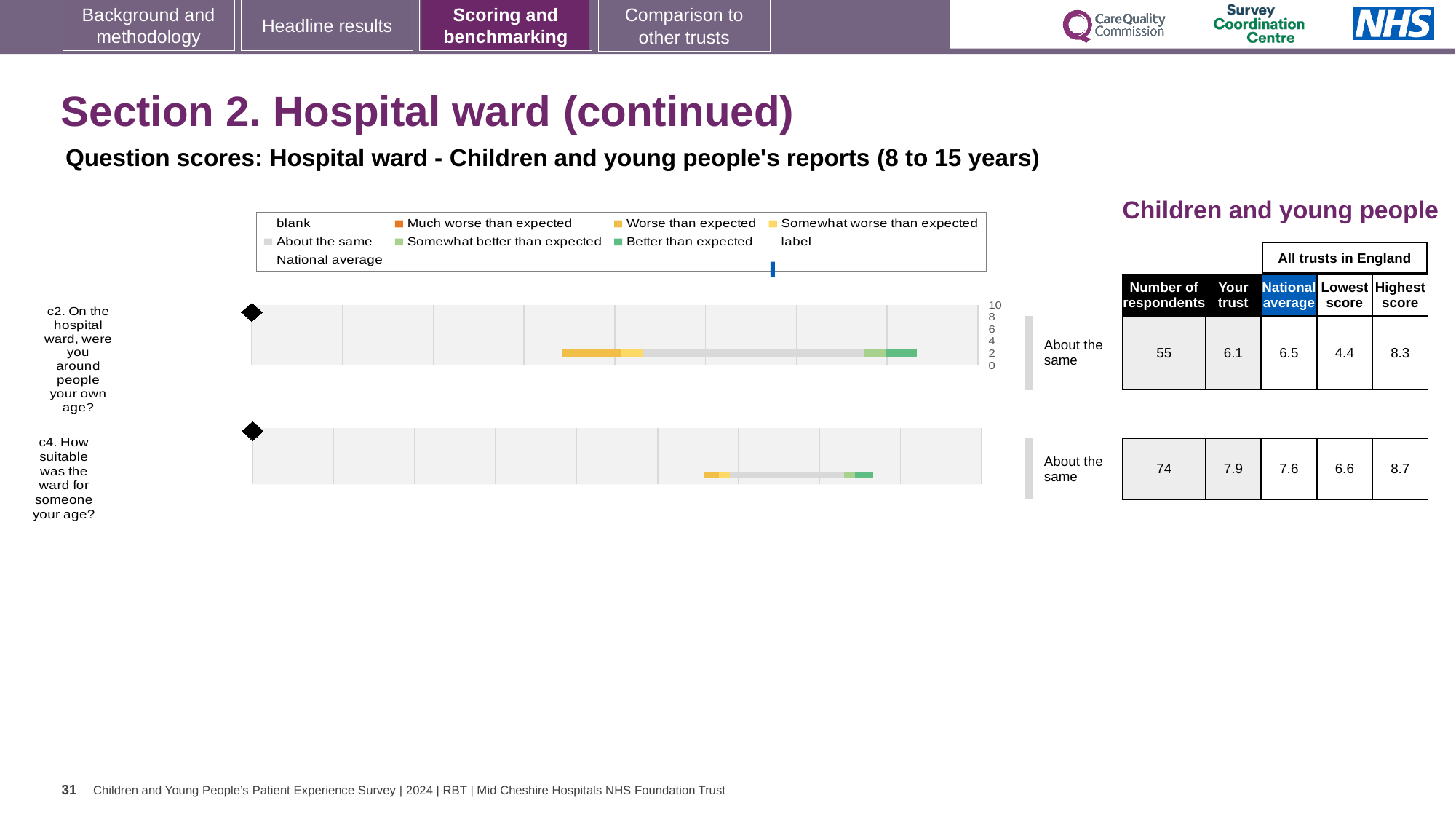
Which question has the higher 'Your trust' score, c2 or c4? c4 Which legend entry is shown in dark green? Better than expected What is the highest score across all trusts in England for question c4? 8.7 How many questions are plotted in the chart on this slide? 2 What is the 'Your trust' score for question c2 (On the hospital ward, were you around people your own age?)? 6.1 What kind of chart is used to show the question scores on this slide? bar chart What benchmarking category is shown for question c2? About the same How many respondents answered question c2? 55 What is the lowest score across all trusts in England for question c4? 6.6 What is the difference between the highest score and the lowest score for question c2? 3.9 By how much does the trust's score for question c4 exceed the national average? 0.3 What is the national average score for question c4 (How suitable was the ward for someone your age?)? 7.6